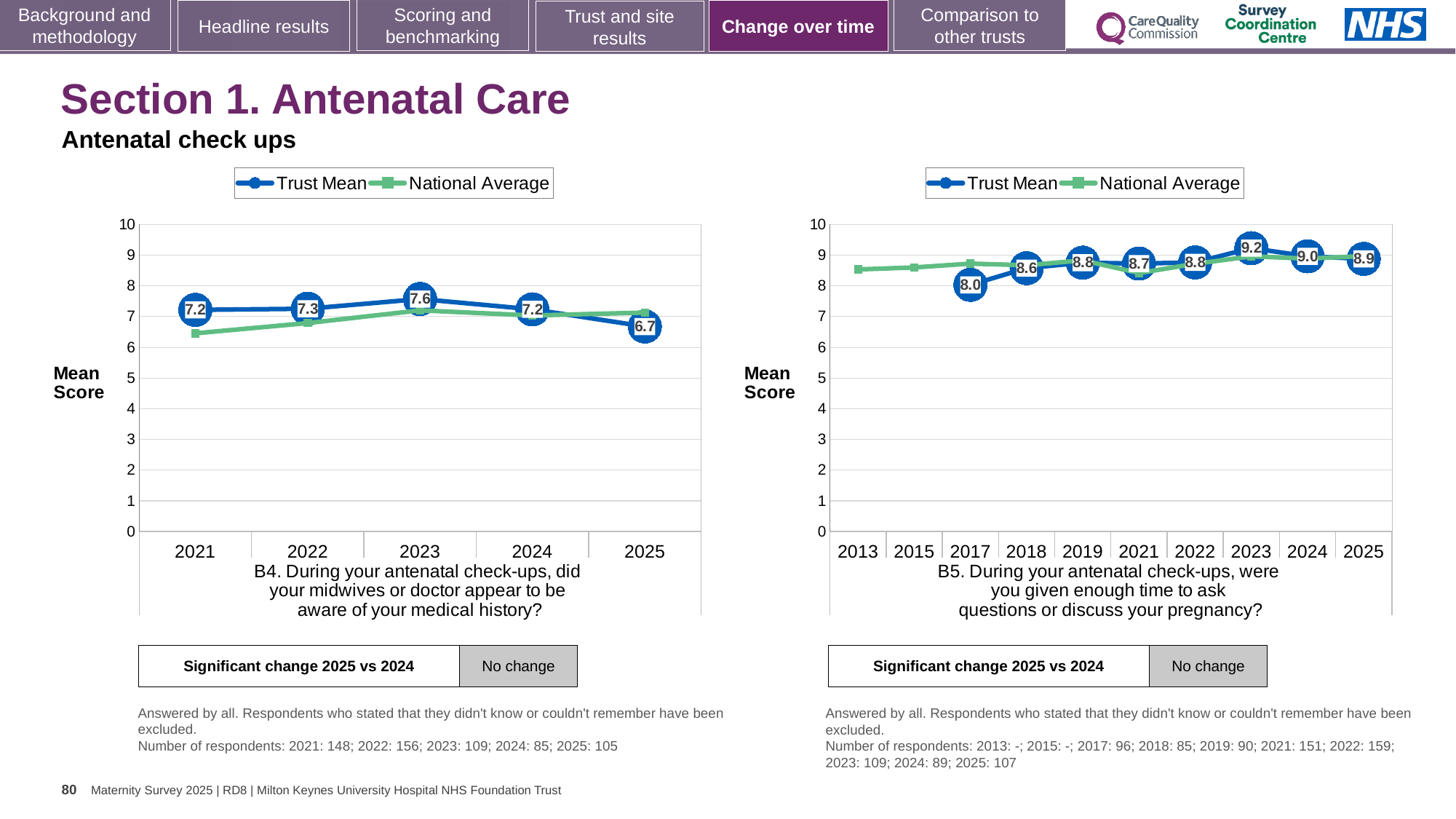
In the left chart (B4), what is the Trust Mean score for 2025? 6.7 In the right chart (B5), is the Trust Mean score for 2024 higher or lower than for 2017? higher How many series does the legend of the left chart (B4) list? 2 In the left chart (B4), what is the difference between the Trust Mean scores for 2023 and 2025? 0.9 In the left chart (B4), how many years are shown on the x axis? 5 In the right chart (B5), is the National Average value for 2013 greater or less than 8? greater In the left chart (B4), what is the Trust Mean score for 2023? 7.6 In the right chart (B5), what is the difference between the Trust Mean scores for 2023 and 2025? 0.3 What type of chart is the right chart (B5)? line chart In the right chart (B5), which year has the highest Trust Mean score? 2023 In the right chart (B5), what is the Trust Mean score for 2017? 8.0 In the left chart (B4), which year has the lowest Trust Mean score? 2025